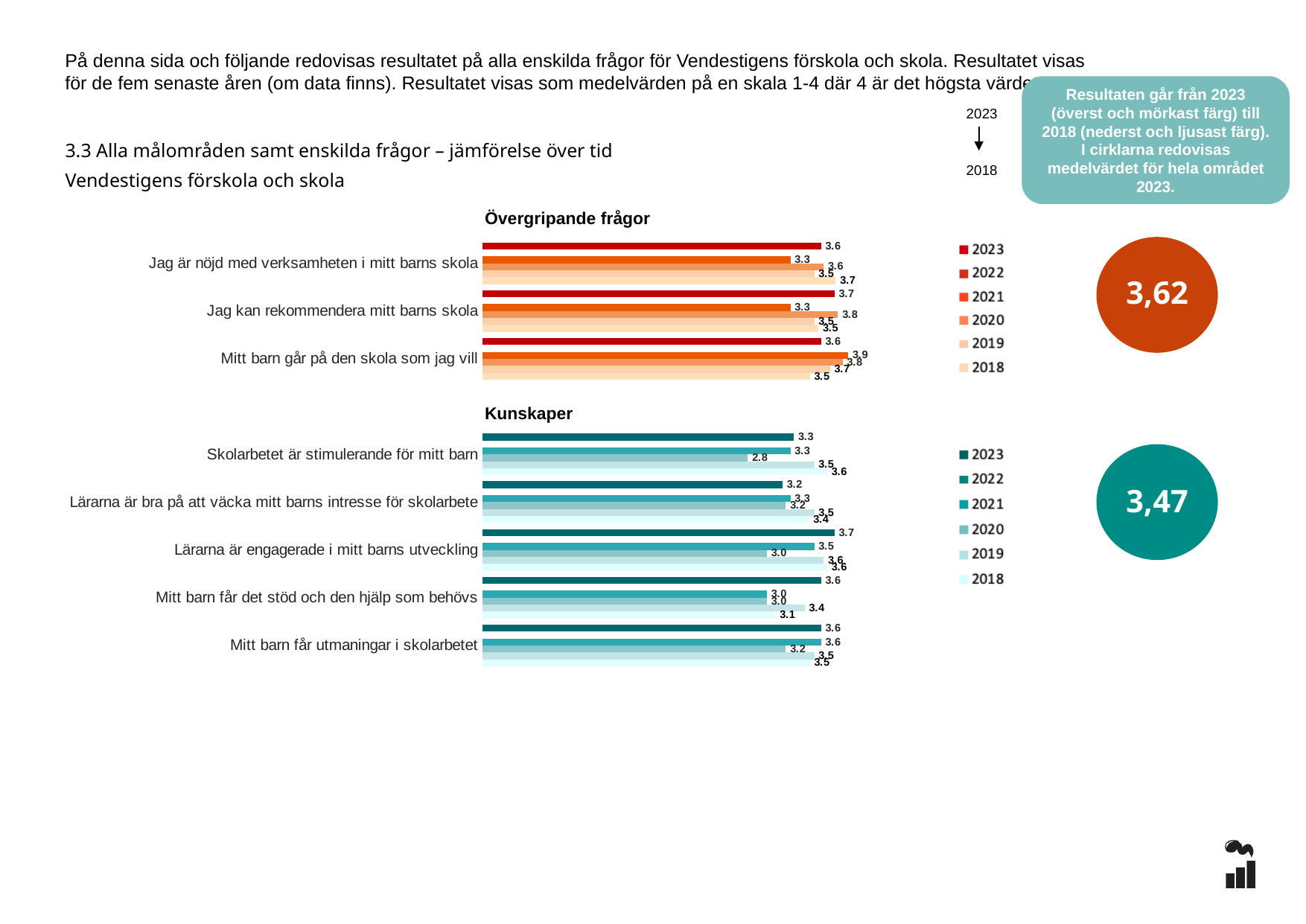
In the Kunskaper chart, what is the 2021 value for "Skolarbetet är stimulerande för mitt barn"? 3.3 How many series (years) does the legend of the Övergripande frågor chart list? 6 What overall 2023 mean value is shown in the circle next to the Kunskaper chart? 3,47 How many questions (categories) are shown in the Kunskaper chart? 5 In the Kunskaper chart, what is the 2023 value for "Lärarna är engagerade i mitt barns utveckling"? 3.7 In the Kunskaper chart, which question has the highest 2023 value? Lärarna är engagerade i mitt barns utveckling In the Övergripande frågor chart, what is the 2023 value for "Jag kan rekommendera mitt barns skola"? 3.7 In the Kunskaper chart, which question has the lowest 2023 value? Lärarna är bra på att väcka mitt barns intresse för skolarbete In the Övergripande frågor chart, which is larger for 2023: "Jag är nöjd med verksamheten i mitt barns skola" or "Jag kan rekommendera mitt barns skola"? Jag kan rekommendera mitt barns skola What kind of chart is the Kunskaper chart? Bar chart